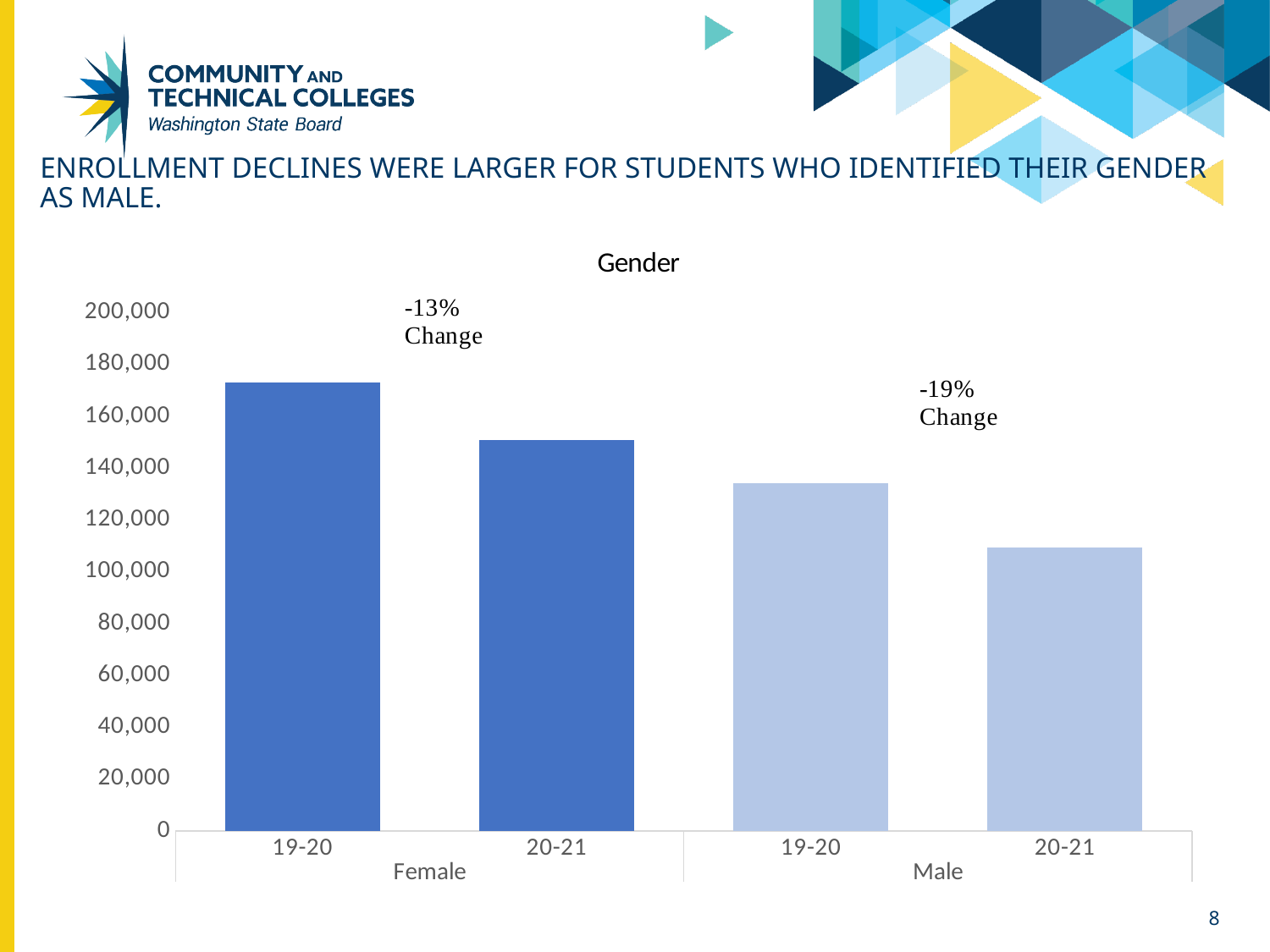
What is the title of the chart? Gender Is the value for Male 20-21 greater or less than 120,000? less Which bar is the shortest in the chart? Male 20-21 Which is larger, the Female 20-21 bar or the Male 19-20 bar? Female 20-21 Is the value for Male 19-20 greater or less than 120,000? greater What kind of chart is shown on the slide? bar chart Do the Female bars rise or fall from 19-20 to 20-21? fall Which bar is the tallest in the chart? Female 19-20 How many bars are plotted in the chart? 4 What percentage change is annotated above the Male bars? -19% Change Is the value for Female 19-20 greater or less than 160,000? greater